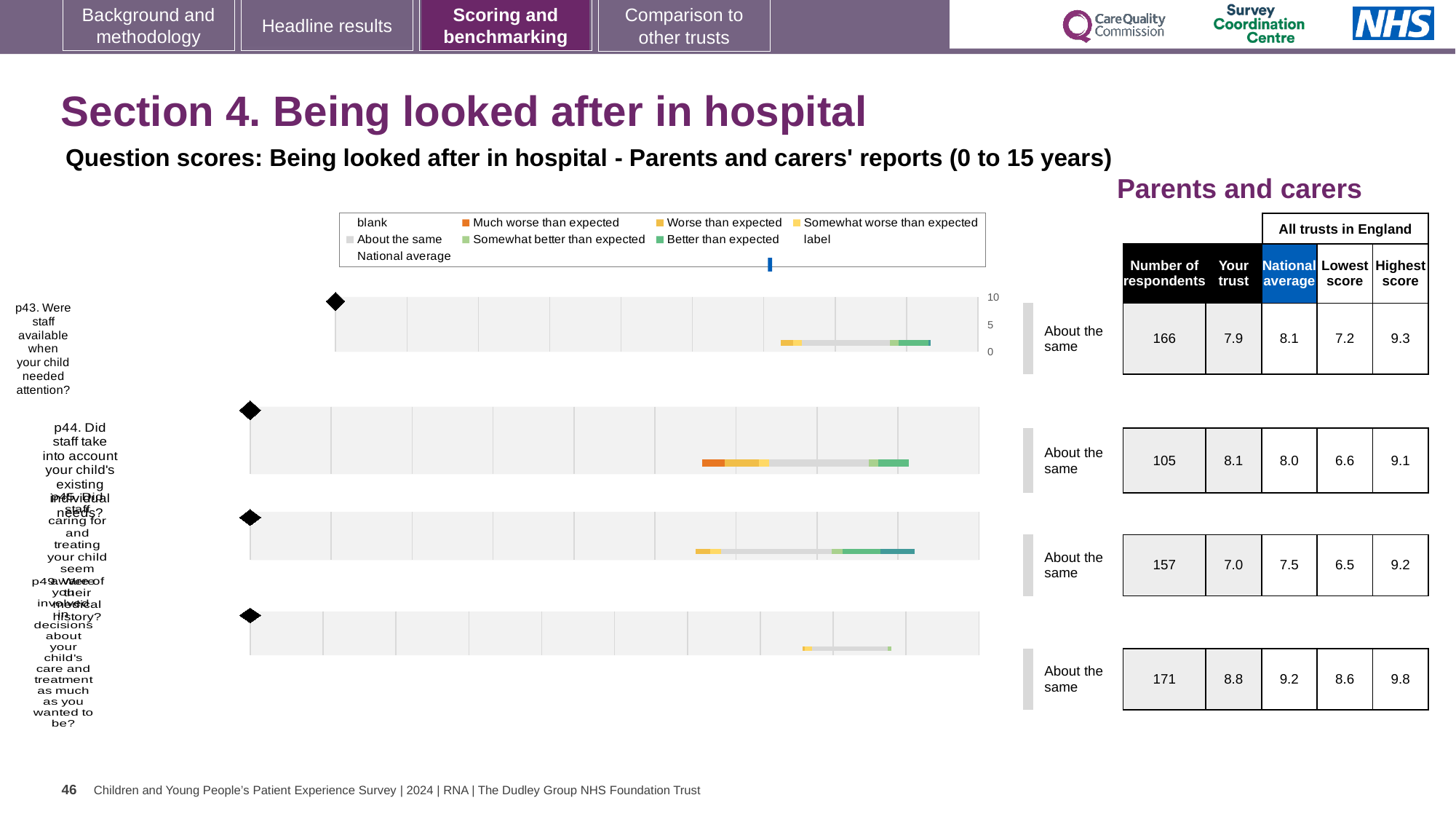
What is the highest value shown on the axis of the top bar chart? 10 What kind of chart is used to show the question scores on this slide? bar chart In the table beside the charts, what is the 'Your trust' score in the first row (p43)? 7.9 In the table beside the charts, what is the number of respondents in the first row (p43)? 166 In the table beside the charts, which row has the lowest 'Your trust' score? the third row (p45), 7.0 In the table beside the charts, which row has the highest 'Your trust' score? the fourth row (p49), 8.8 In the chart legend, which colour represents 'Much worse than expected'? orange In the table beside the charts, what is the highest score in the third row (p45)? 9.2 In the table beside the charts, what is the national average in the second row (p44)? 8.0 How many question bar charts are shown on the slide? 4 In the table beside the charts, what is the lowest score in the fourth row (p49)? 8.6 In the table beside the charts, what is the difference between the national average and 'Your trust' score in the fourth row (p49)? 0.4